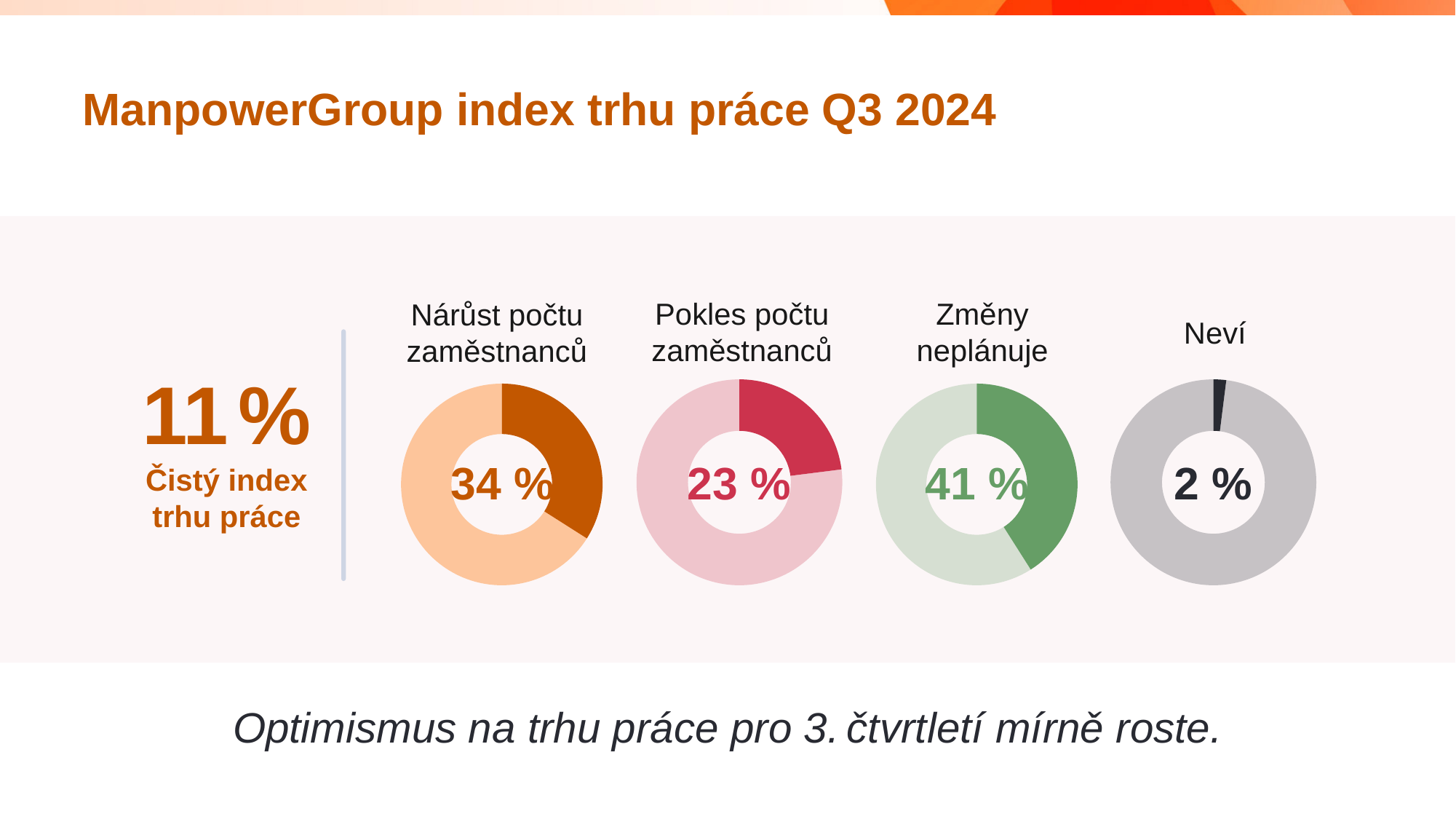
What is the difference between the value in the "Změny neplánuje" chart and the value in the "Nárůst počtu zaměstnanců" chart? 7 % Which of the four donut charts shows the lowest value? Neví What value is shown in the donut chart titled "Neví"? 2 % What value is shown in the donut chart titled "Nárůst počtu zaměstnanců"? 34 % What is the difference between the value in the "Nárůst počtu zaměstnanců" chart and the value in the "Pokles počtu zaměstnanců" chart? 11 % How many donut charts are shown on the slide? 4 What type of chart is used to show the value for "Neví"? Donut chart Which is larger: the value in the "Nárůst počtu zaměstnanců" chart or the value in the "Pokles počtu zaměstnanců" chart? Nárůst počtu zaměstnanců What value is shown in the donut chart titled "Pokles počtu zaměstnanců"? 23 % Which of the four donut charts shows the highest value? Změny neplánuje What value is shown in the donut chart titled "Změny neplánuje"? 41 % What is the value of the "Čistý index trhu práce" shown to the left of the donut charts? 11 %